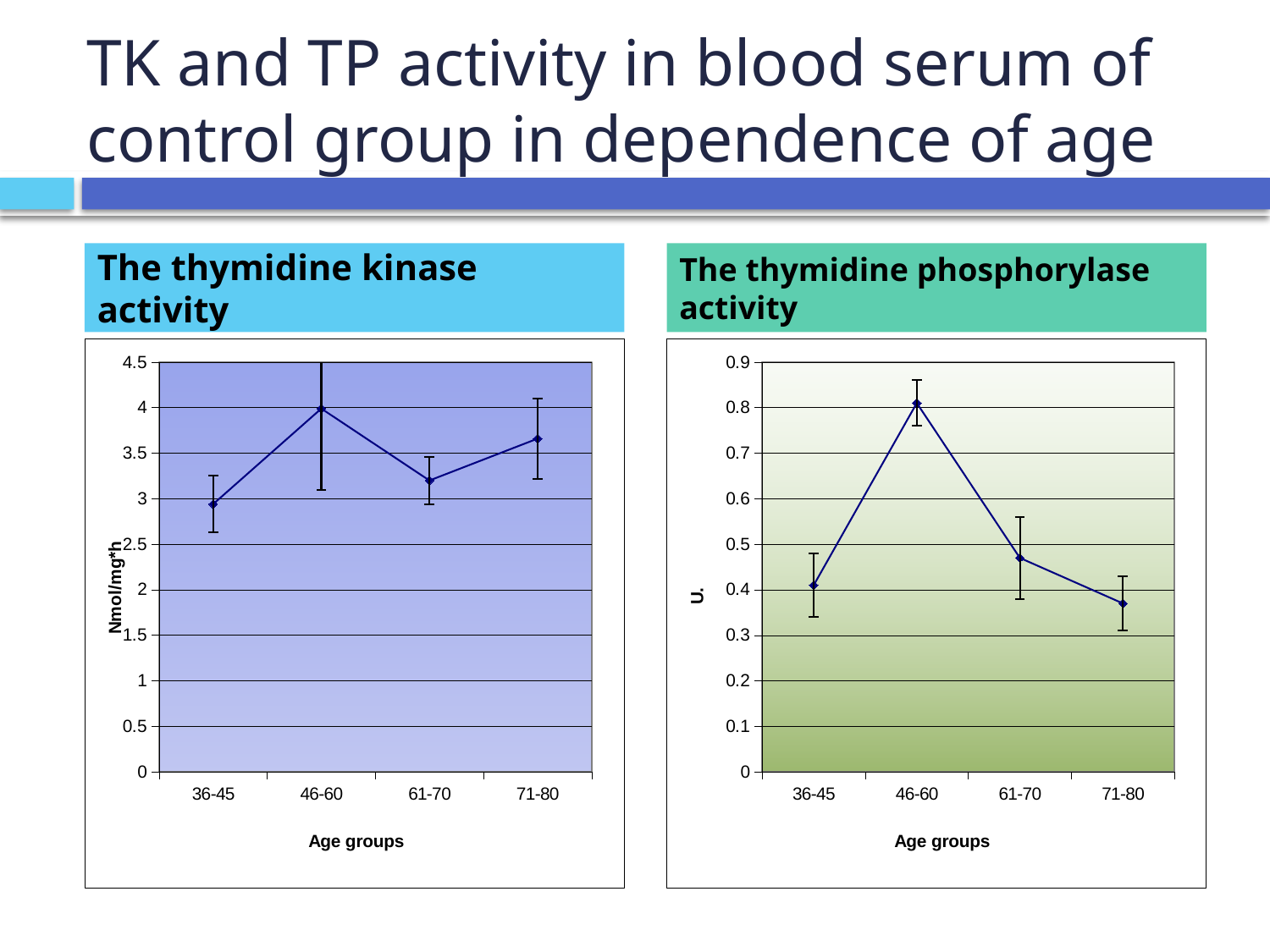
In the thymidine kinase activity chart, which age group has the lowest value? 36-45 In the thymidine phosphorylase activity chart, is the value for the 36-45 age group greater or less than 0.5? less In the thymidine phosphorylase activity chart, is the value for the 46-60 age group greater or less than 0.7? greater What kind of chart is the thymidine kinase activity chart on the left? line chart In the thymidine phosphorylase activity chart, do the values rise or fall from the 46-60 age group to the 71-80 age group? fall In the thymidine phosphorylase activity chart, which age group has the highest value? 46-60 What is the y-axis label of the thymidine kinase activity chart? Nmol/mg*h How many age groups are plotted on the x axis of the thymidine phosphorylase activity chart? 4 In the thymidine kinase activity chart, which age group has the highest value? 46-60 In the thymidine kinase activity chart, which is larger, the value for 61-70 or the value for 71-80? 71-80 In the thymidine kinase activity chart, is the value for the 71-80 age group greater or less than 3.5? greater